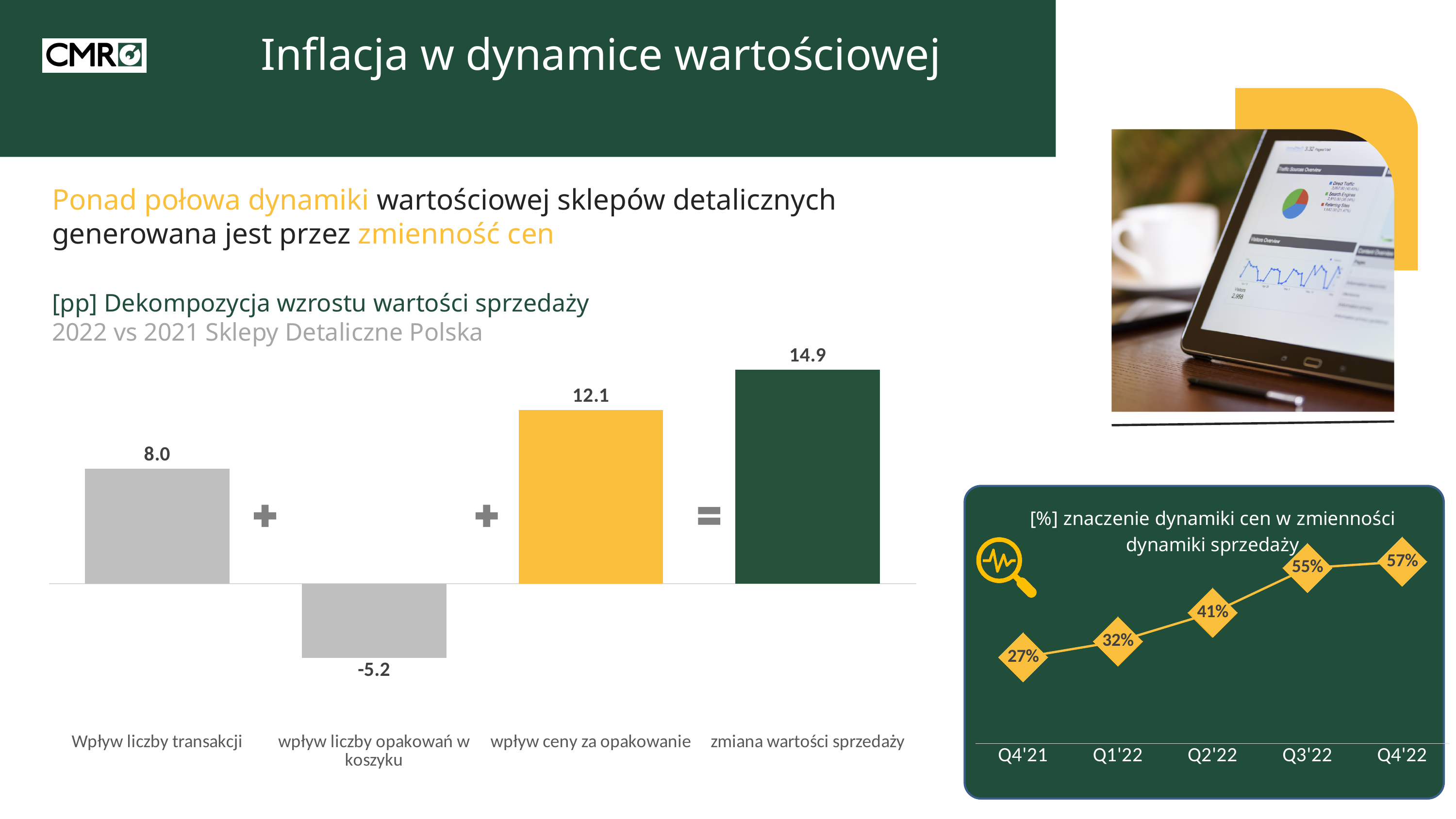
In the bar chart "[pp] Dekompozycja wzrostu wartości sprzedaży", what is the value for "Wpływ liczby transakcji"? 8.0 In the bar chart "[pp] Dekompozycja wzrostu wartości sprzedaży", which category has the highest value? zmiana wartości sprzedaży In the line chart "[%] znaczenie dynamiki cen w zmienności dynamiki sprzedaży", what is the difference between Q4'22 and Q4'21? 30% In the line chart "[%] znaczenie dynamiki cen w zmienności dynamiki sprzedaży", which quarter has the lowest value? Q4'21 In the bar chart "[pp] Dekompozycja wzrostu wartości sprzedaży", what is the value for "wpływ ceny za opakowanie"? 12.1 In the bar chart "[pp] Dekompozycja wzrostu wartości sprzedaży", what is the difference between "wpływ ceny za opakowanie" and "Wpływ liczby transakcji"? 4.1 In the bar chart "[pp] Dekompozycja wzrostu wartości sprzedaży", how many bars are shown? 4 In the bar chart "[pp] Dekompozycja wzrostu wartości sprzedaży", which category has the lowest value? wpływ liczby opakowań w koszyku In the line chart "[%] znaczenie dynamiki cen w zmienności dynamiki sprzedaży", do the values rise or fall from Q4'21 to Q4'22? rise In the bar chart "[pp] Dekompozycja wzrostu wartości sprzedaży", what is the value for "wpływ liczby opakowań w koszyku"? -5.2 What kind of chart is "[pp] Dekompozycja wzrostu wartości sprzedaży"? bar chart In the line chart "[%] znaczenie dynamiki cen w zmienności dynamiki sprzedaży", what is the value for Q2'22? 41%